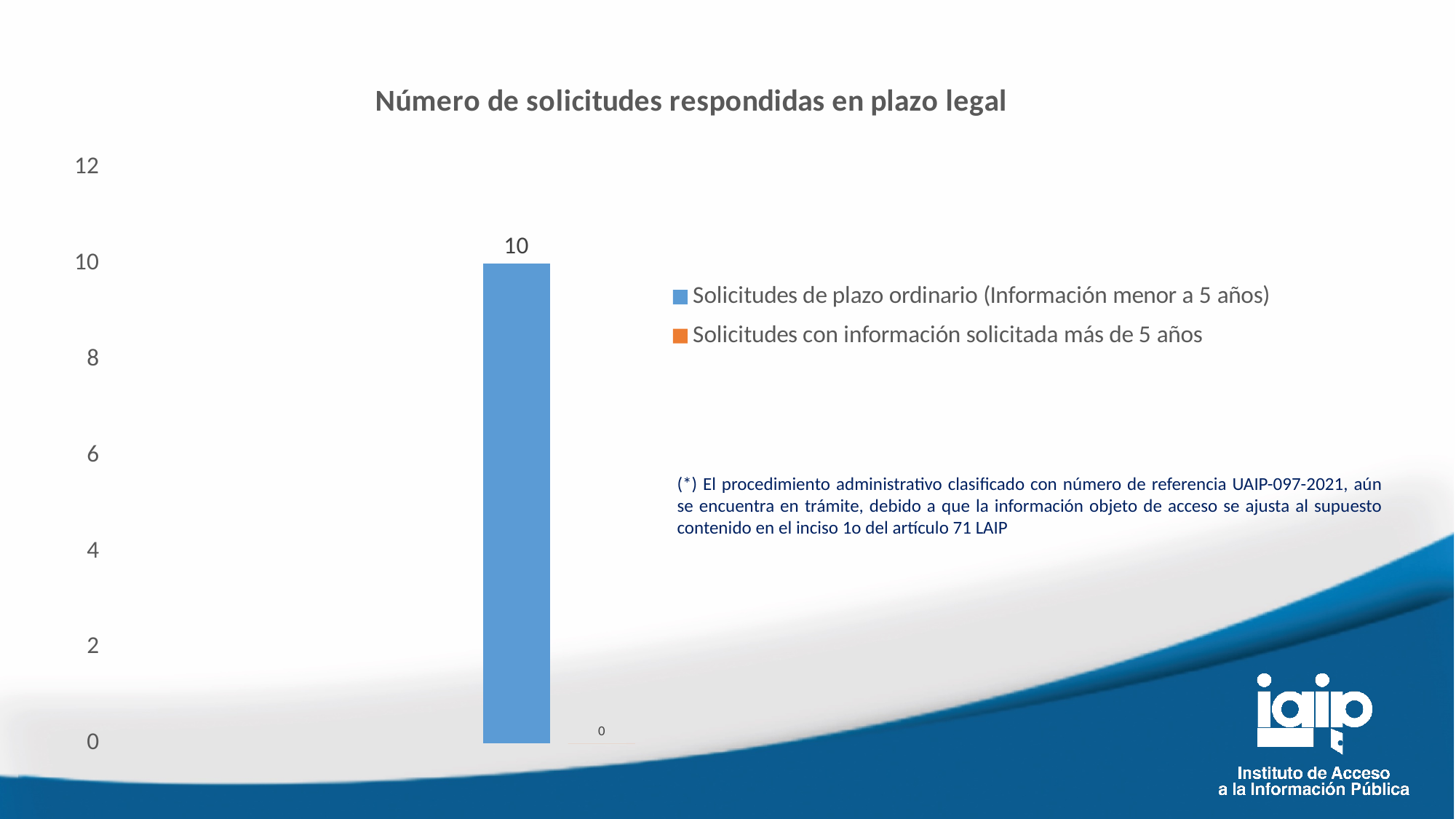
Which series has the highest value? Solicitudes de plazo ordinario (Información menor a 5 años) Is the value for Solicitudes de plazo ordinario greater or less than 12? less What is the title of the chart? Número de solicitudes respondidas en plazo legal Is the value for Solicitudes de plazo ordinario greater or less than 8? greater What kind of chart is shown on the slide? bar chart How many series does the legend list? 2 What is the difference between the value for Solicitudes de plazo ordinario and the value for Solicitudes con información solicitada más de 5 años? 10 What is the value for Solicitudes de plazo ordinario (Información menor a 5 años)? 10 What is the value for Solicitudes con información solicitada más de 5 años? 0 What colour represents Solicitudes con información solicitada más de 5 años in the legend? orange Which series has the lowest value? Solicitudes con información solicitada más de 5 años Which is larger: the value for Solicitudes de plazo ordinario or the value for Solicitudes con información solicitada más de 5 años? Solicitudes de plazo ordinario (Información menor a 5 años)